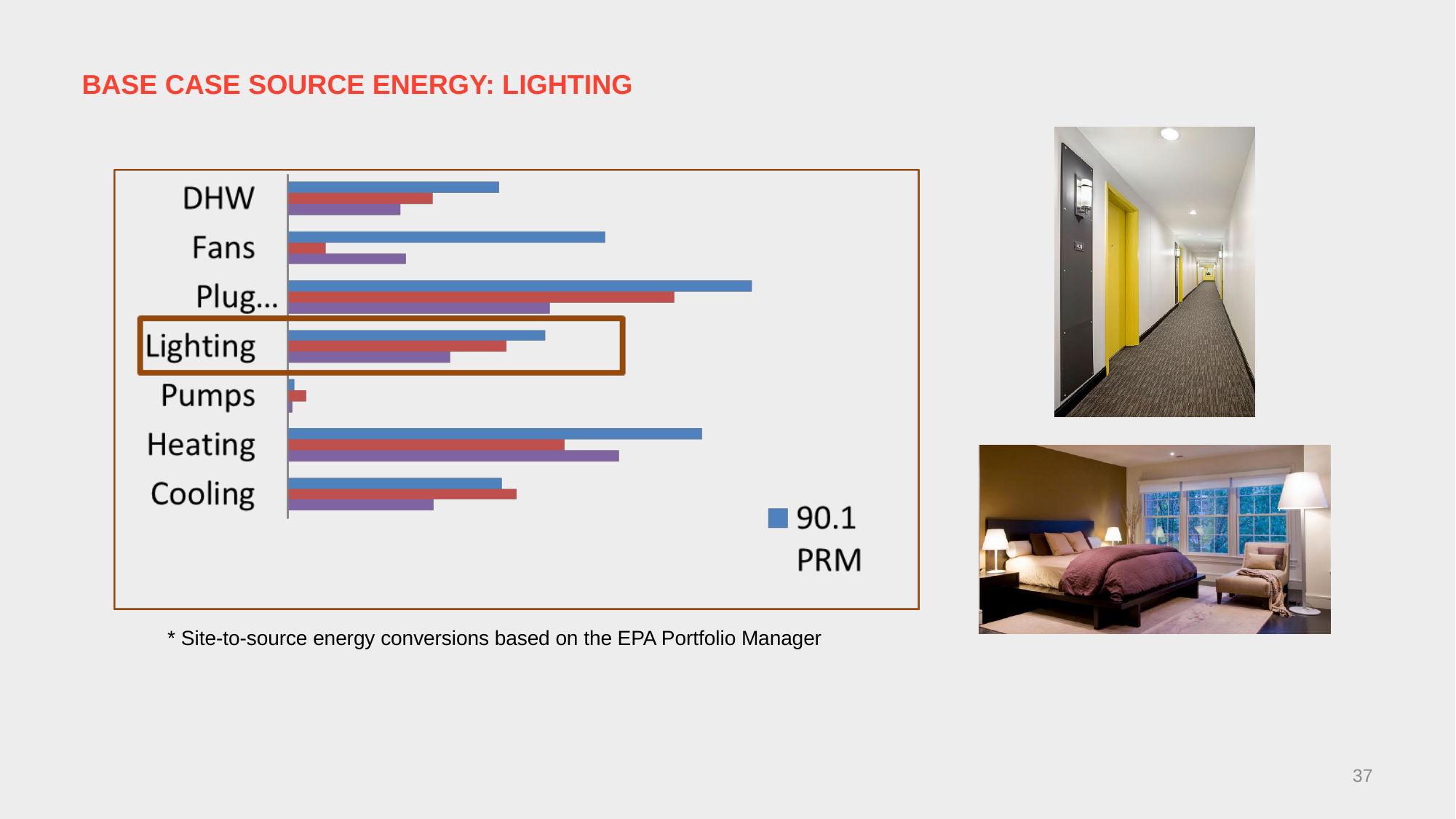
How many bars are plotted for each category on the chart? 3 Is the red bar for DHW longer or shorter than the red bar for Fans? longer How many categories are shown on the chart's vertical axis? 7 Which category has the longest red bar? Plug... Which category has the longest blue bar? Plug... What kind of chart is shown on the slide? bar chart Is the blue bar for Fans longer or shorter than the blue bar for DHW? longer Which category has the shortest purple bar? Pumps Which category has the longest purple bar? Heating What legend entry is shown for the blue series? 90.1 PRM Which category has the shortest blue bar? Pumps Which category is highlighted with an orange box on the chart? Lighting